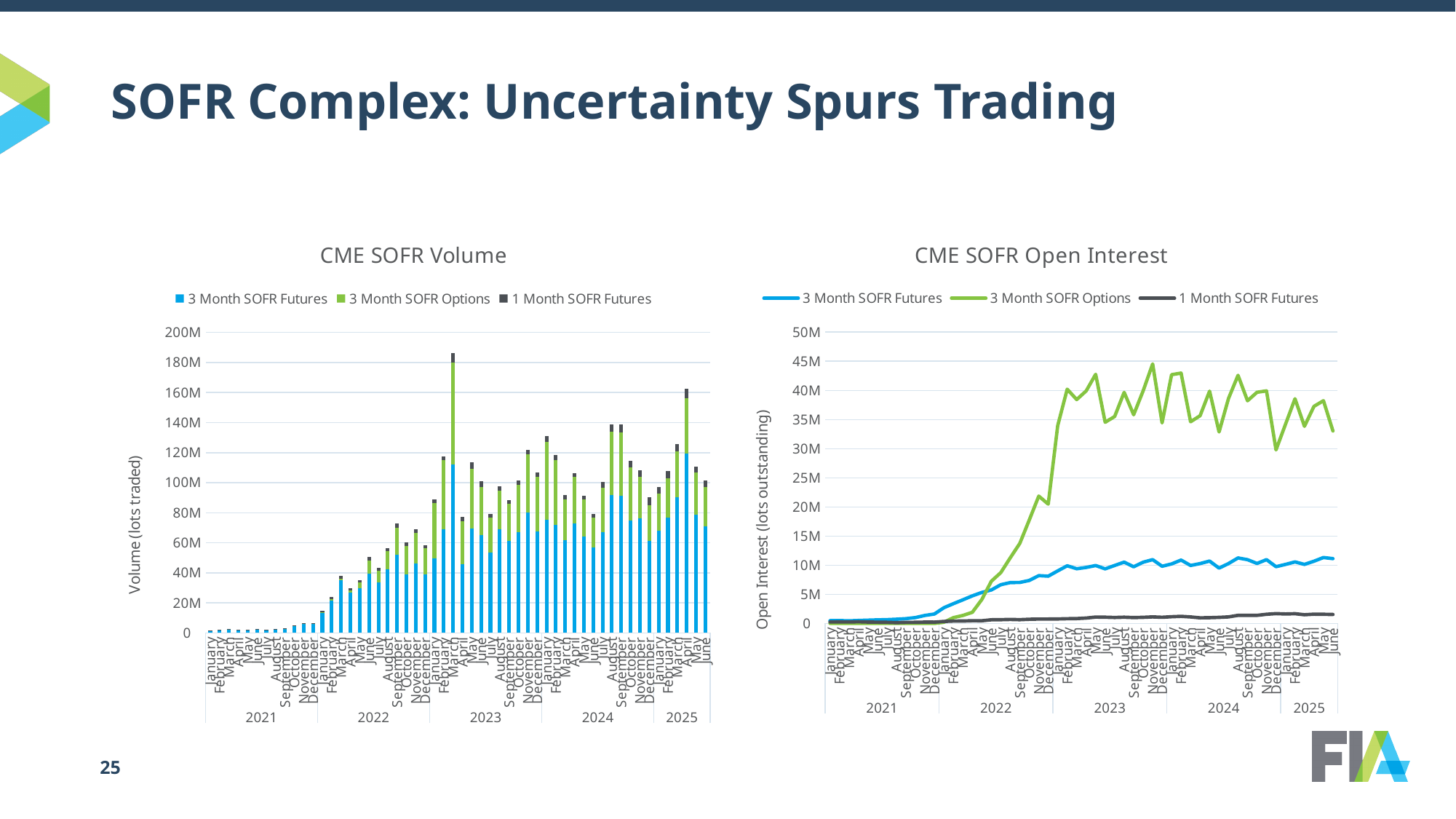
How many years are labelled on the x axis of the CME SOFR Volume chart? 5 In the CME SOFR Open Interest chart, is the value for 3 Month SOFR Options in June 2025 greater or less than 30M? greater In the CME SOFR Open Interest chart, does the 3 Month SOFR Futures line rise or fall from 2021 to 2025? rise What kind of chart is the CME SOFR Open Interest chart? line chart How many series does the legend of the CME SOFR Volume chart list? 3 In the CME SOFR Open Interest chart, is the value for 1 Month SOFR Futures in June 2025 greater or less than 5M? less In the CME SOFR Open Interest chart, which series is higher in 2025, 3 Month SOFR Options or 3 Month SOFR Futures? 3 Month SOFR Options What is the y-axis label of the CME SOFR Volume chart? Volume (lots traded) How many series does the legend of the CME SOFR Open Interest chart list? 3 What kind of chart is the CME SOFR Volume chart? bar chart In the CME SOFR Open Interest chart, is the value for 3 Month SOFR Futures in June 2025 greater or less than 15M? less What is the y-axis label of the CME SOFR Open Interest chart? Open Interest (lots outstanding)